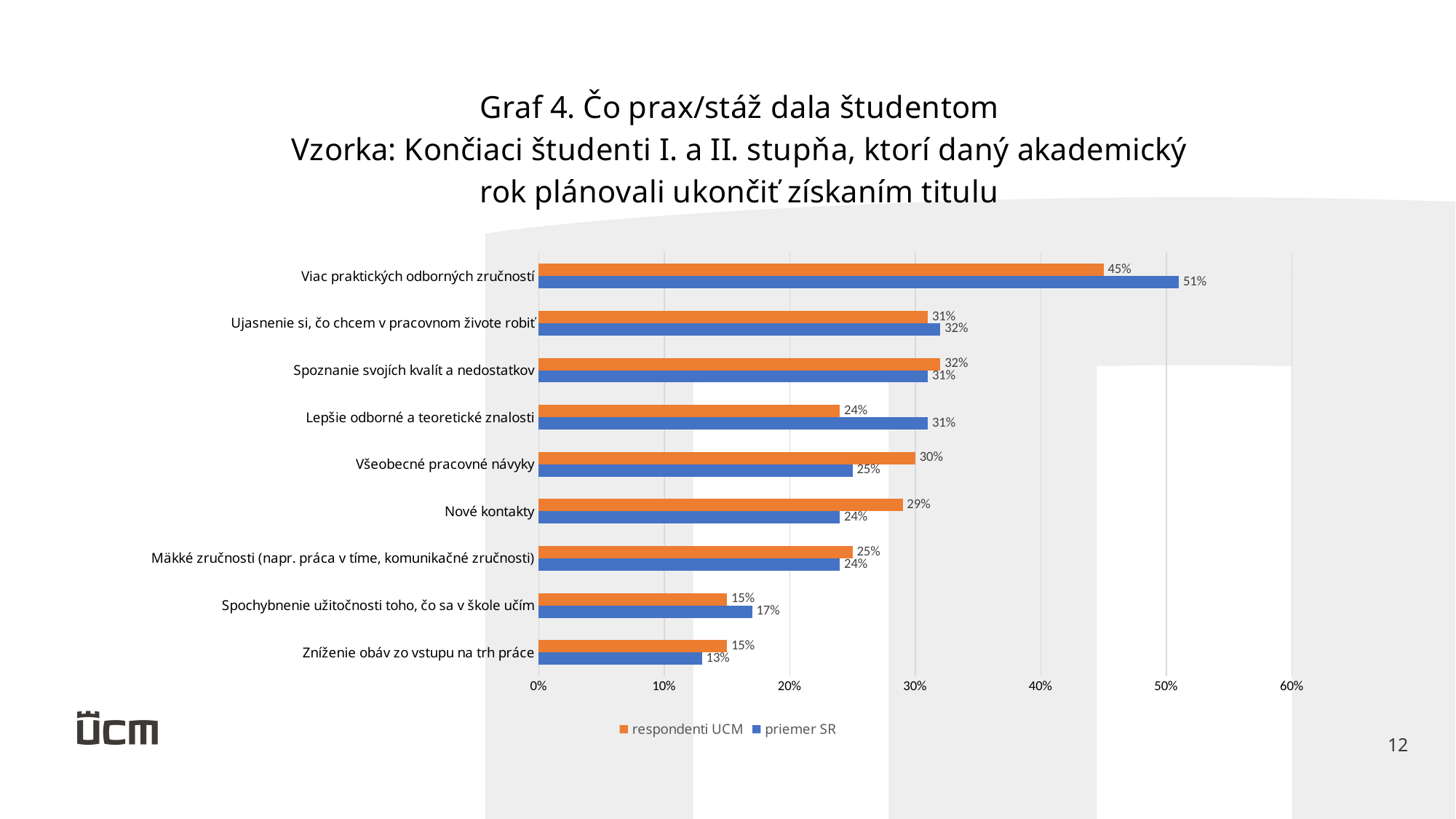
How many categories are shown on the chart? 9 How many series does the legend list? 2 What is the difference between 'priemer SR' and 'respondenti UCM' for 'Viac praktických odborných zručností'? 6% For 'Nové kontakty', which series has the larger value, 'respondenti UCM' or 'priemer SR'? respondenti UCM What is the value for 'priemer SR' for 'Lepšie odborné a teoretické znalosti'? 31% What is the value for 'priemer SR' for 'Zníženie obáv zo vstupu na trh práce'? 13% What kind of chart is shown on the slide? Bar chart Which category has the lowest value for 'priemer SR'? Zníženie obáv zo vstupu na trh práce What is the value for 'respondenti UCM' for 'Viac praktických odborných zručností'? 45% Which category has the highest value for 'priemer SR'? Viac praktických odborných zručností Which colour represents the 'priemer SR' series? Blue Is the value for 'respondenti UCM' for 'Všeobecné pracovné návyky' greater or less than 20%? greater